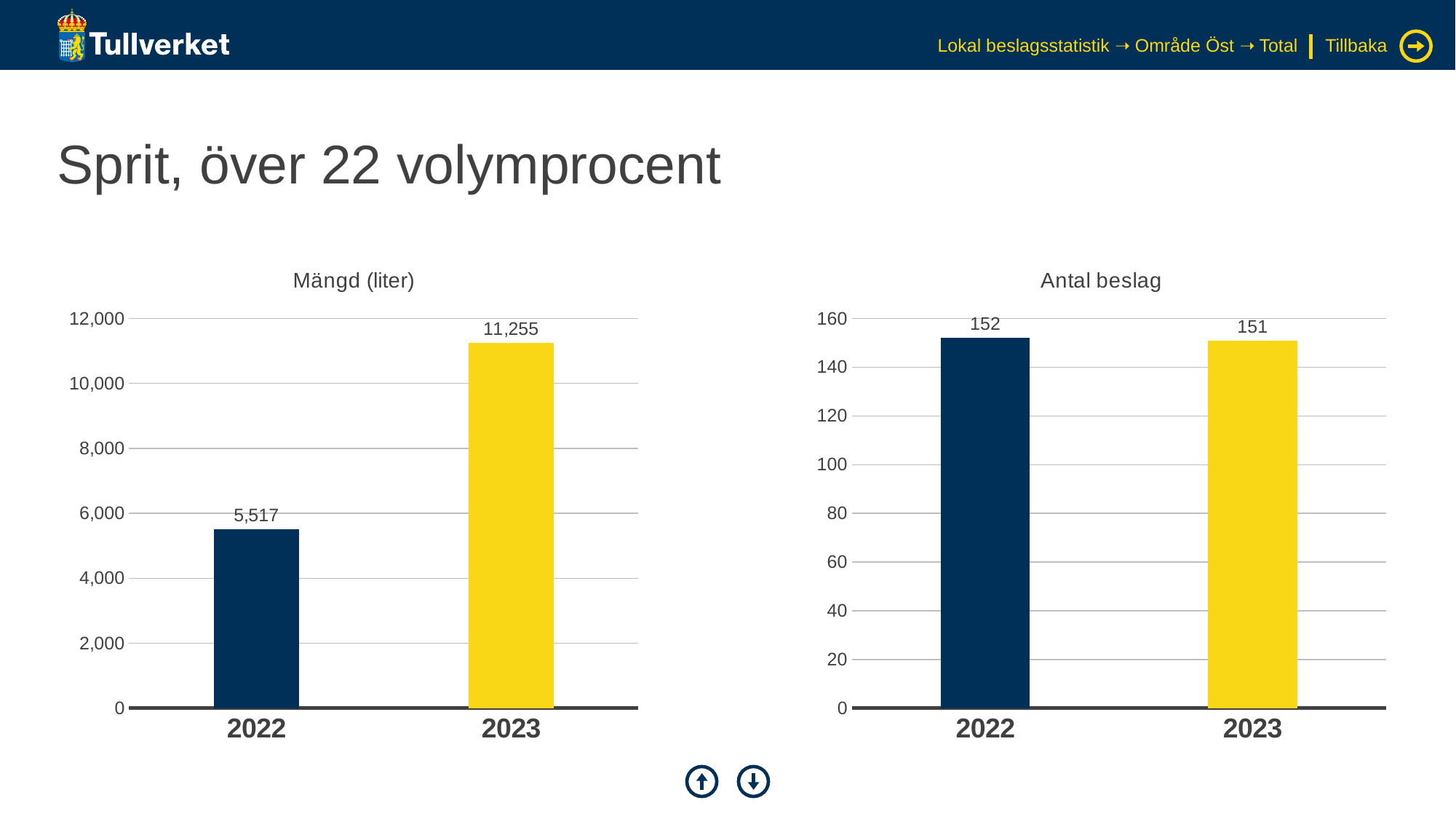
In the 'Mängd (liter)' chart, what is the difference between the 2023 and 2022 values? 5,738 In the 'Antal beslag' chart, what is the value for 2022? 152 In the 'Mängd (liter)' chart, is the value for 2022 greater or less than 6,000? less In the 'Antal beslag' chart, what is the value for 2023? 151 In the 'Mängd (liter)' chart, do the values rise or fall from 2022 to 2023? rise In the 'Mängd (liter)' chart, what is the value for 2023? 11,255 In the 'Mängd (liter)' chart, what is the value for 2022? 5,517 How many categories are shown in the 'Antal beslag' chart? 2 In the 'Antal beslag' chart, what is the difference between the 2022 and 2023 values? 1 What kind of chart is the 'Mängd (liter)' chart? bar chart In the 'Mängd (liter)' chart, which year has the highest value? 2023 In the 'Antal beslag' chart, is the value for 2023 greater or less than 140? greater